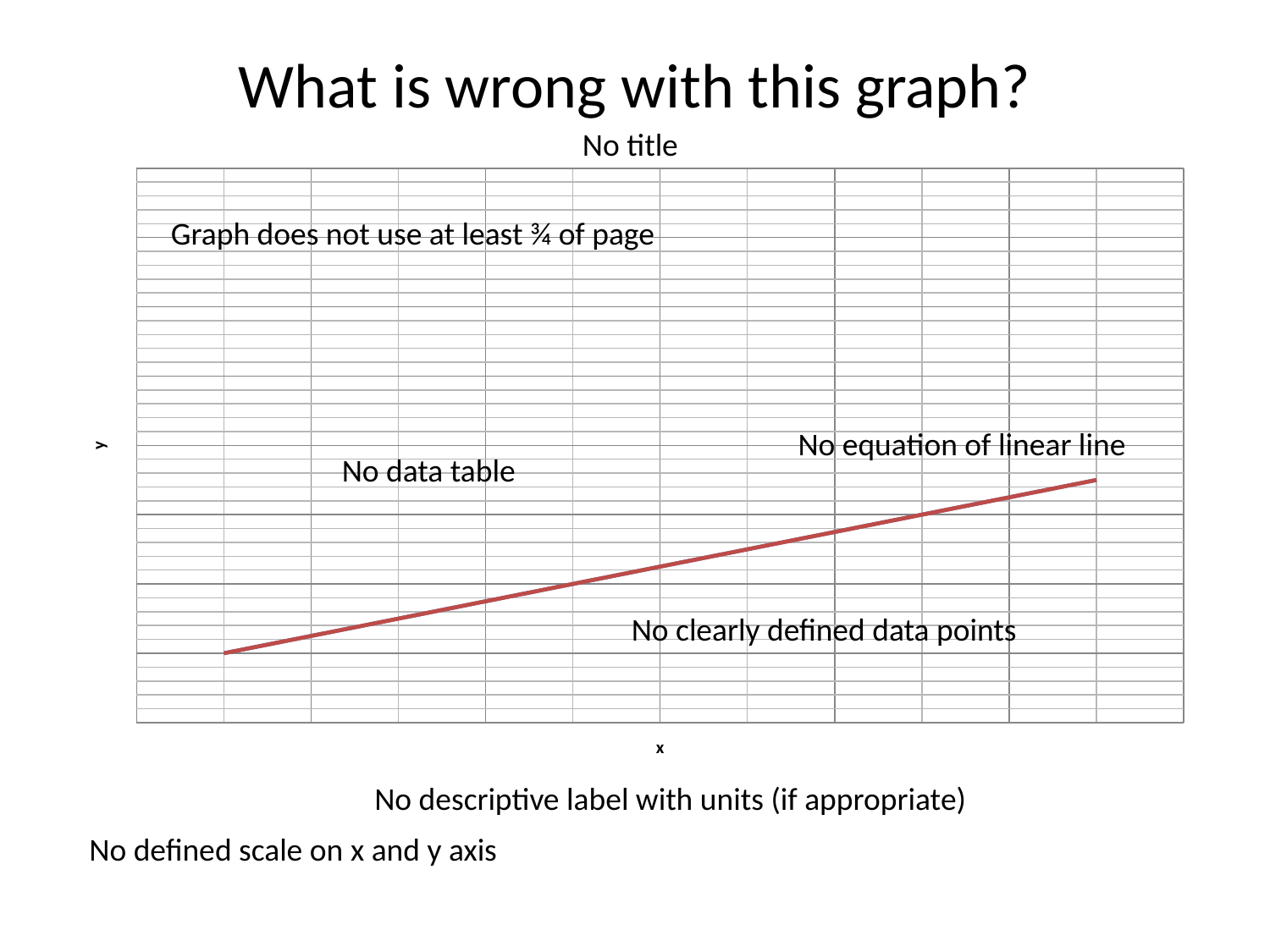
What is the label on the horizontal axis of the chart? x What is the label on the vertical axis of the chart? y Does the plotted line rise or fall as you move from left to right along the x axis? rise What kind of chart is shown on the slide? line chart